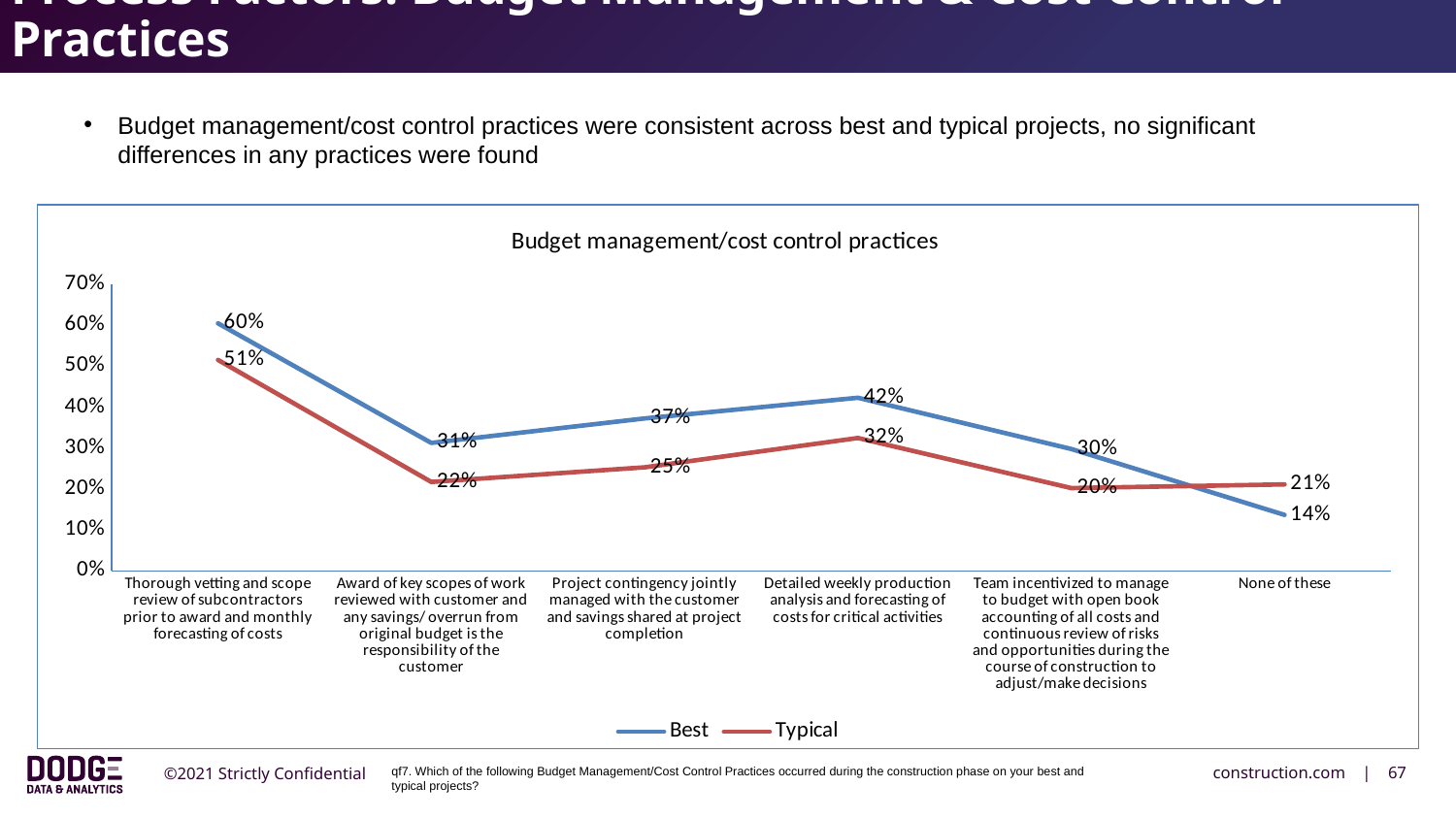
What is the difference between the Best and Typical values for 'Project contingency jointly managed with the customer and savings shared at project completion'? 12% What is the Typical value for 'Detailed weekly production analysis and forecasting of costs for critical activities'? 32% What kind of chart is shown? Line chart How many series does the legend list? 2 What is the title of the chart? Budget management/cost control practices Is the Best value for 'Detailed weekly production analysis and forecasting of costs for critical activities' greater or less than 40%? greater For 'None of these', which series has the larger value, Best or Typical? Typical What is the Best value for 'Thorough vetting and scope review of subcontractors prior to award and monthly forecasting of costs'? 60% Which category has the highest Typical value? Thorough vetting and scope review of subcontractors prior to award and monthly forecasting of costs Which category has the lowest Best value? None of these How many categories are shown on the x axis? 6 What is the Best value for 'None of these'? 14%